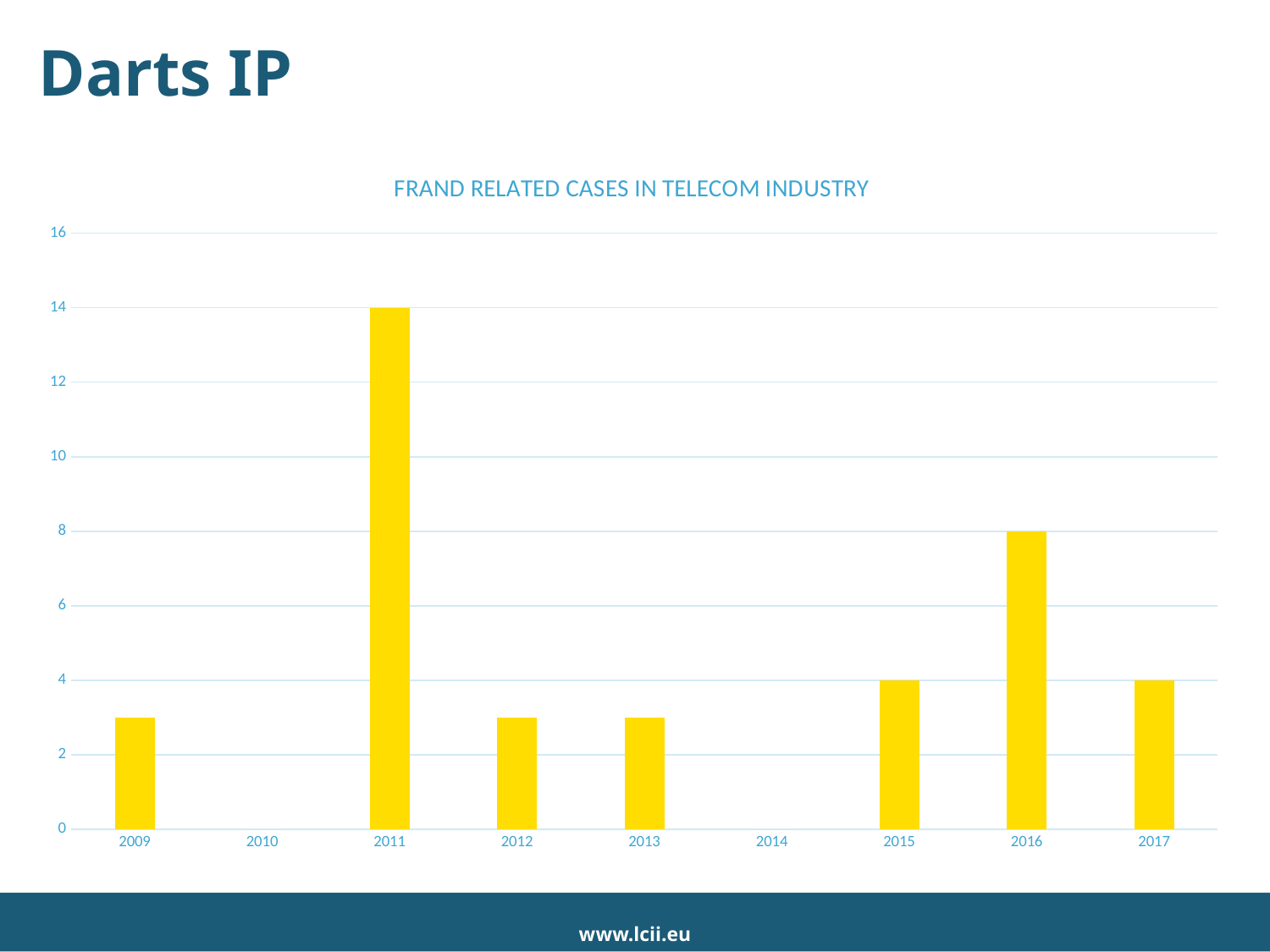
How many FRAND related cases are shown for 2015? 4 How many FRAND related cases are shown for 2011? 14 How many FRAND related cases are shown for 2014? 0 Is the value for 2012 greater or less than 4? less What is the title of the chart? FRAND RELATED CASES IN TELECOM INDUSTRY How many years are shown on the x axis of the chart? 9 How many FRAND related cases are shown for 2017? 4 Which year has more FRAND related cases, 2015 or 2016? 2016 What kind of chart is shown on the slide? bar chart How many FRAND related cases are shown for 2016? 8 What is the difference between the number of cases in 2011 and in 2016? 6 Which year has the highest number of FRAND related cases? 2011